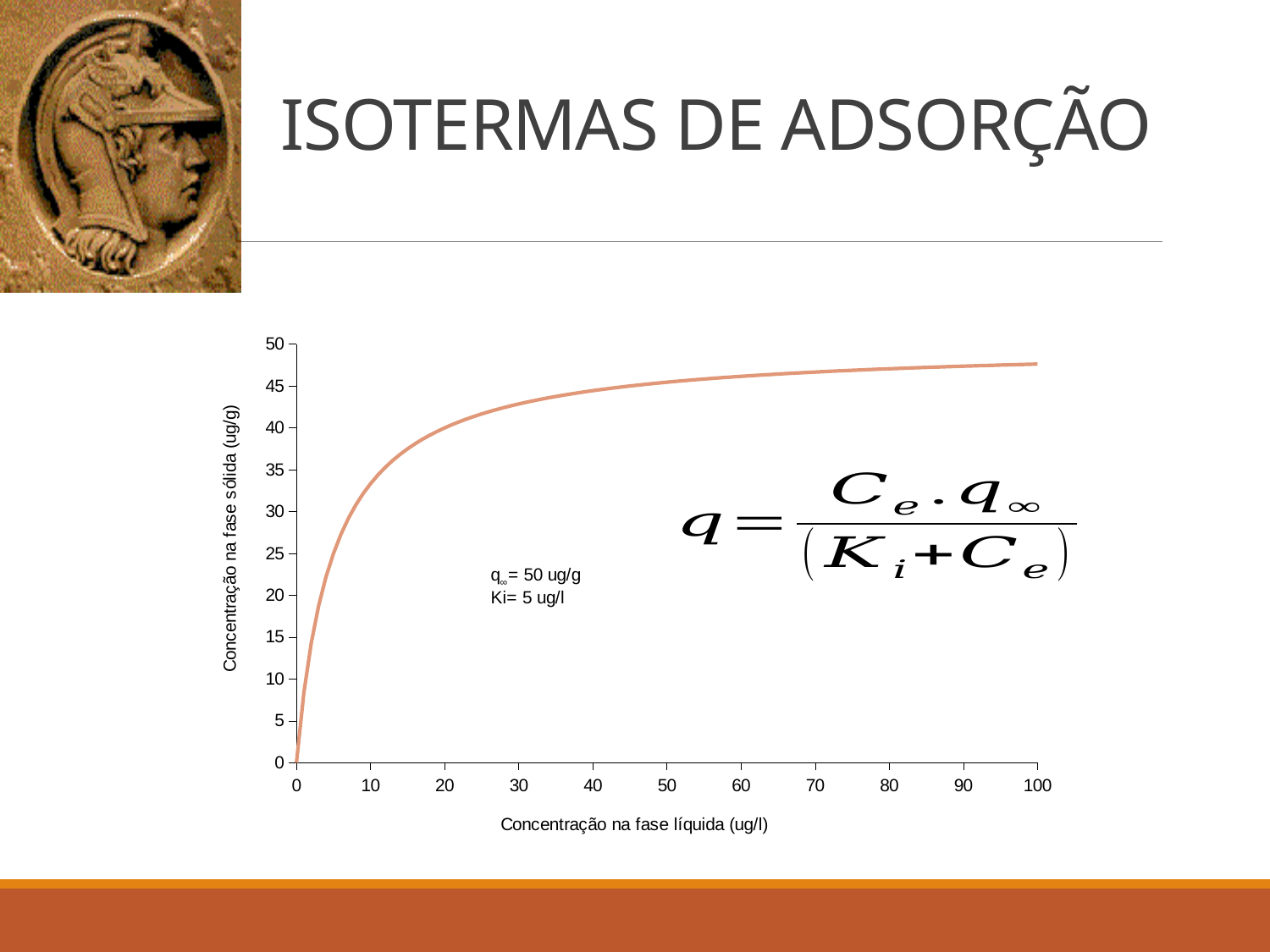
Is the value of the curve at a liquid-phase concentration of 10 ug/l greater or less than 30? greater Is the value of the curve at a liquid-phase concentration of 50 ug/l greater or less than 40? greater What is the label of the x axis of the chart? Concentração na fase líquida (ug/l) Does the concentration in the solid phase rise or fall as the concentration in the liquid phase increases? rise Is the value of the curve at a liquid-phase concentration of 10 ug/l greater or less than 35? less What is the value of the curve at a liquid-phase concentration of 0 ug/l? 0 What value of Ki is stated on the chart? 5 ug/l What kind of chart is shown on the slide? line chart